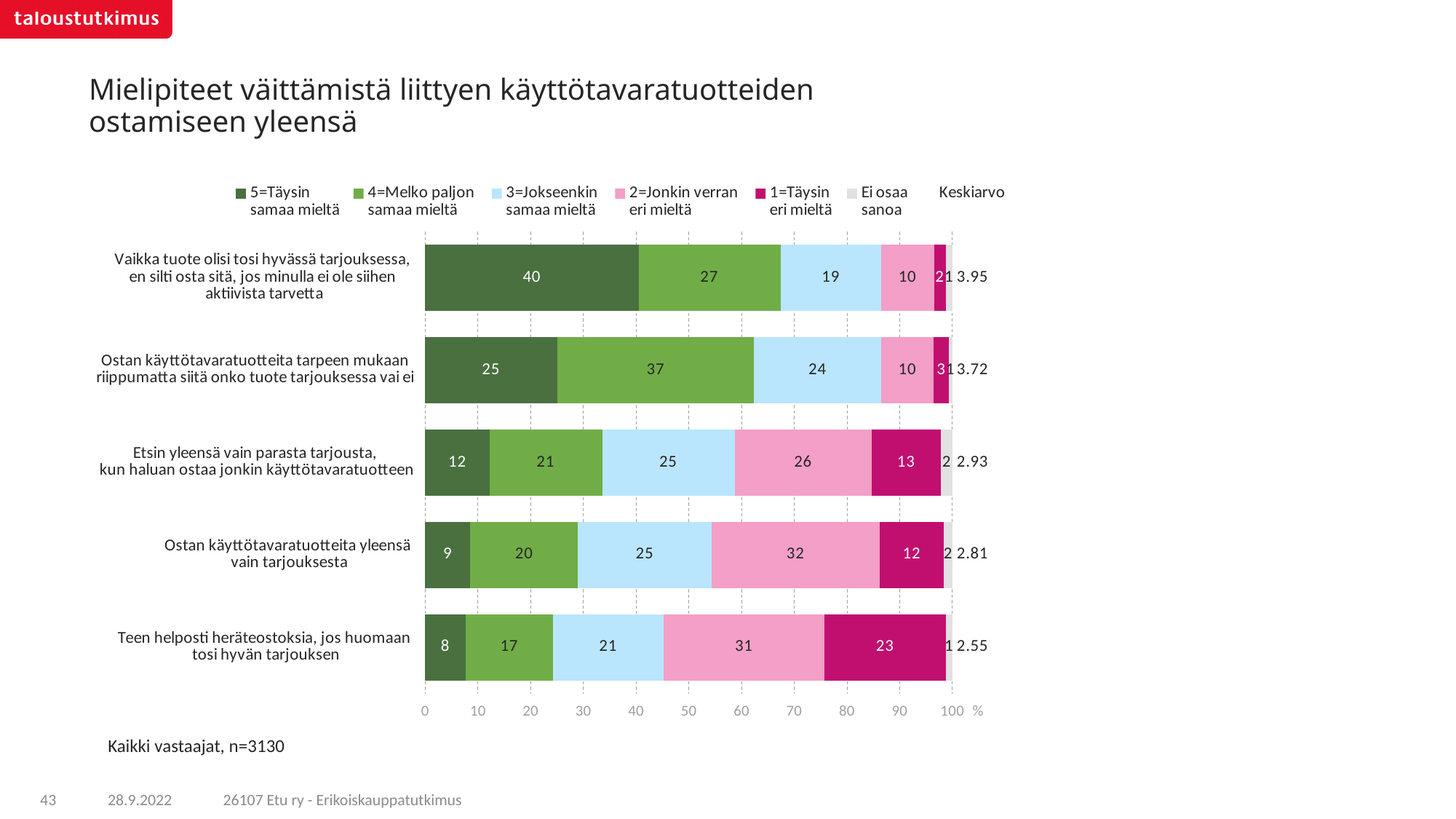
What is the difference in the "2=Jonkin verran eri mieltä" share between "Ostan käyttötavaratuotteita yleensä vain tarjouksesta" and "Etsin yleensä vain parasta tarjousta, kun haluan ostaa jonkin käyttötavaratuotteen"? 6 What percentage answered "4=Melko paljon samaa mieltä" to "Ostan käyttötavaratuotteita tarpeen mukaan riippumatta siitä onko tuote tarjouksessa vai ei"? 37 Which statement has the highest Keskiarvo (mean) value? Vaikka tuote olisi tosi hyvässä tarjouksessa, en silti osta sitä, jos minulla ei ole siihen aktiivista tarvetta (3.95) Which statement has the lowest share of "5=Täysin samaa mieltä" responses? Teen helposti heräteostoksia, jos huomaan tosi hyvän tarjouksen (8) How many statements (bars) are shown in the chart? 5 Which statement has a larger "1=Täysin eri mieltä" share: "Teen helposti heräteostoksia, jos huomaan tosi hyvän tarjouksen" or "Etsin yleensä vain parasta tarjousta, kun haluan ostaa jonkin käyttötavaratuotteen"? Teen helposti heräteostoksia, jos huomaan tosi hyvän tarjouksen What type of chart is shown on the slide? Stacked bar chart What is the number of respondents (n) stated below the chart? n=3130 What percentage answered "3=Jokseenkin samaa mieltä" to "Etsin yleensä vain parasta tarjousta, kun haluan ostaa jonkin käyttötavaratuotteen"? 25 What is the Keskiarvo (mean) shown for the statement "Teen helposti heräteostoksia, jos huomaan tosi hyvän tarjouksen"? 2.55 What percentage of respondents answered "5=Täysin samaa mieltä" to the statement "Vaikka tuote olisi tosi hyvässä tarjouksessa, en silti osta sitä, jos minulla ei ole siihen aktiivista tarvetta"? 40 How many response categories with colour swatches does the legend list? 6